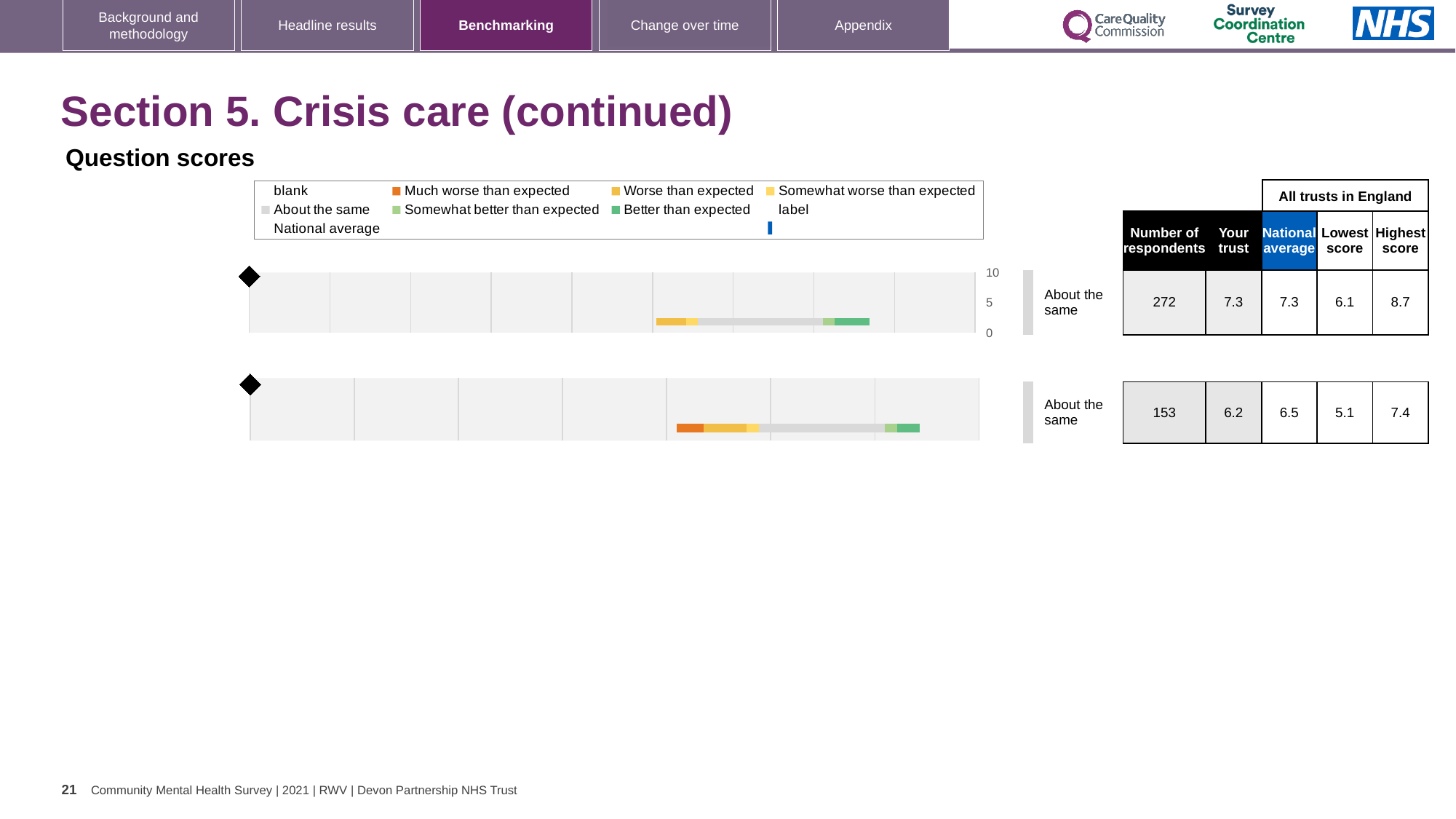
For the second chart's row, what is the difference between the national average and the 'Your trust' score? 0.3 In the table next to the first chart, what is the highest score among all trusts in England? 8.7 For the second chart's row, is the 'Your trust' score or the national average larger? National average In the table next to the first chart, what is the number of respondents? 272 What kind of chart is used for the benchmarking rows on the slide? Bar chart In the table next to the second chart, what is the lowest score among all trusts in England? 5.1 Which row has more respondents, the first chart's row or the second chart's row? The first chart's row What benchmark category label is shown beside both charts? About the same For the first chart's row, what is the difference between the highest score and the lowest score in the table? 2.6 In the table next to the second chart, what is the national average score? 6.5 In the table next to the first chart, what is the 'Your trust' score? 7.3 How many benchmarking charts are shown on the slide? 2